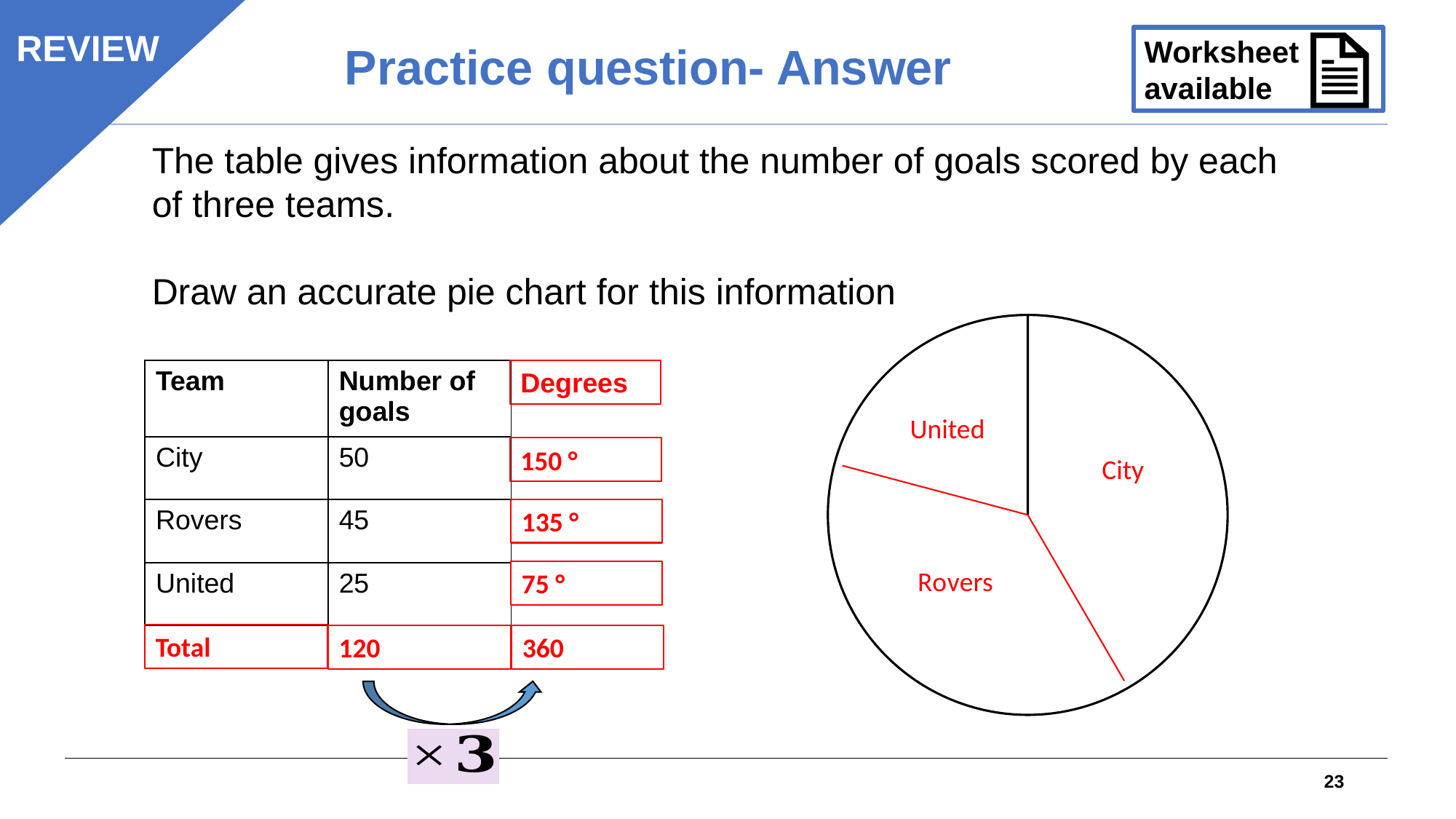
What is the total number of goals scored by the three teams? 120 According to the table, how many degrees does the United slice of the pie chart take up? 75° How many slices does the pie chart have? 3 What colour are the slice labels on the pie chart? red What kind of chart is shown on the slide? pie chart How many goals did Rovers score according to the table? 45 Which team has the smallest slice of the pie chart? United Which team has the largest slice of the pie chart? City According to the table, how many degrees does the City slice of the pie chart take up? 150° Is the slice for Rovers larger or smaller than the slice for United? larger What is the difference in degrees between the City slice and the United slice? 75° According to the table, how many degrees does the Rovers slice of the pie chart take up? 135°